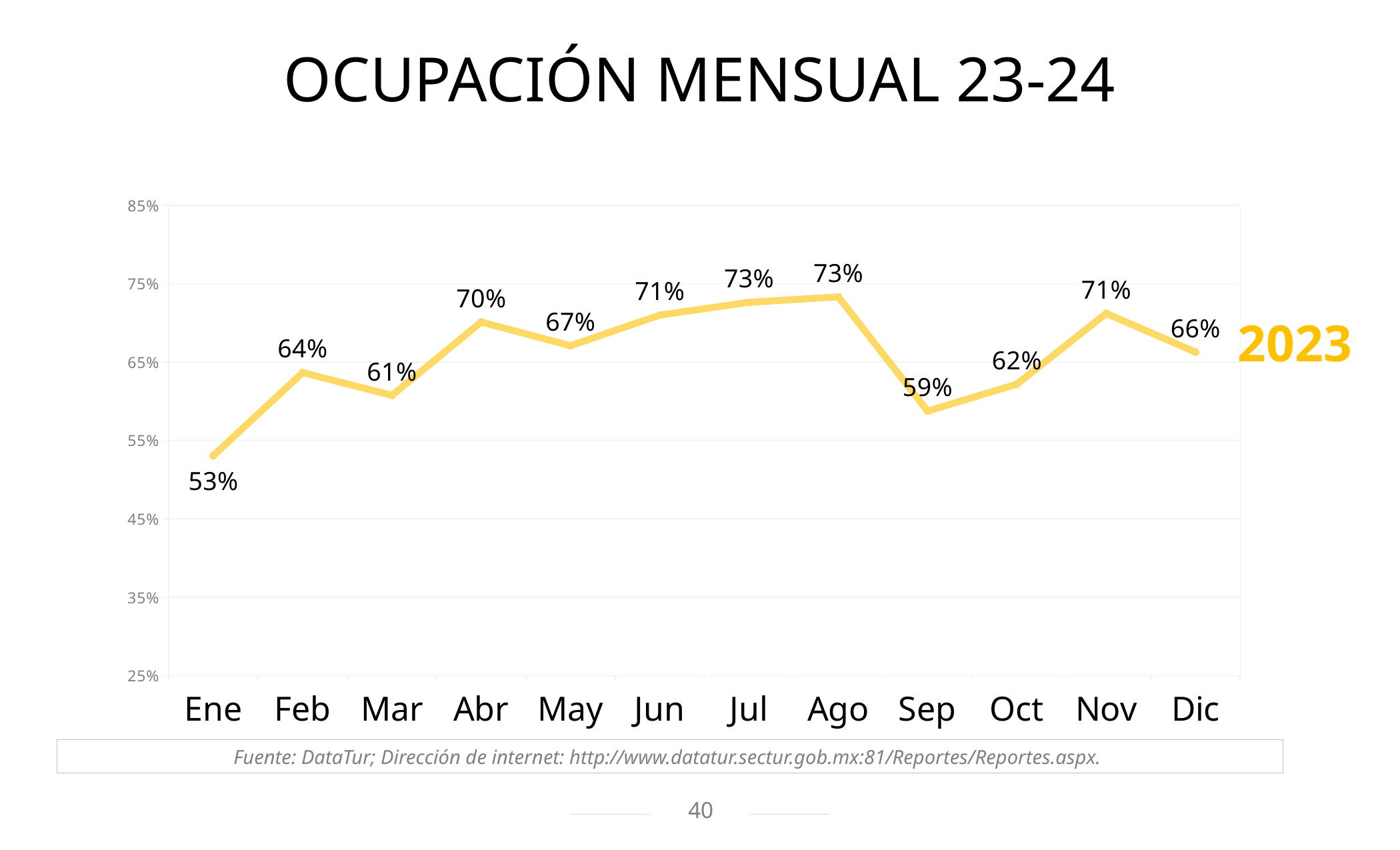
What is the occupancy value for Ene? 53% What kind of chart is shown on the slide? line chart What is the difference between the occupancy values for Feb and Ene? 11% Which is larger, the occupancy value for Mar or for May? May What is the occupancy value for Nov? 71% Which month has the lowest occupancy value? Ene What is the occupancy value for Sep? 59% What is the difference between the occupancy values for Ago and Sep? 14% Is the occupancy value for Oct greater or less than 65%? less What year label is shown next to the line on the chart? 2023 What is the occupancy value for Abr? 70% How many months are plotted on the chart? 12